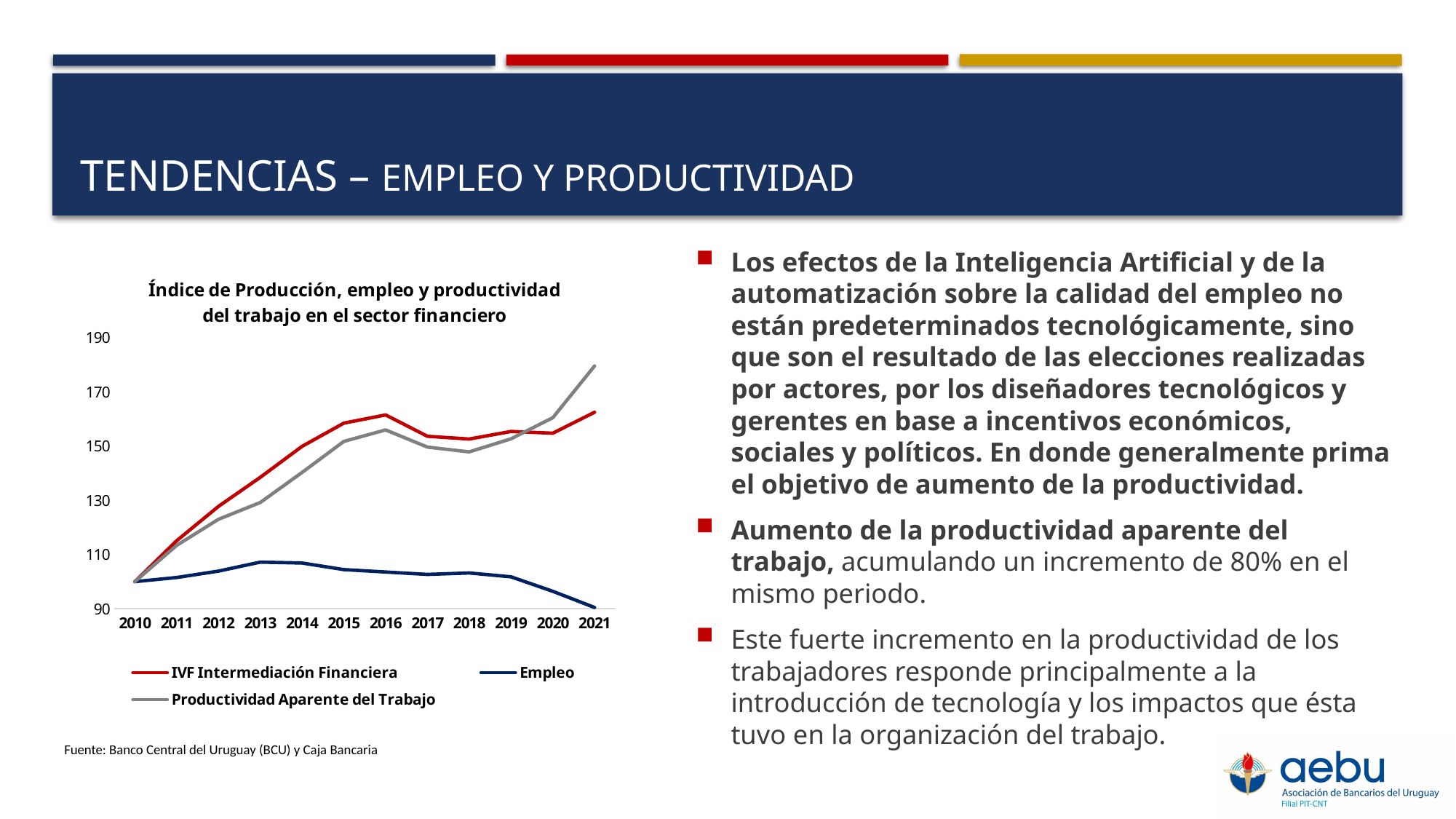
How many years are plotted along the x axis of the chart? 12 Which series has the lowest value in 2021? Empleo What kind of chart is shown on the slide? line chart Which series has the highest value in 2021? Productividad Aparente del Trabajo Is the value for Productividad Aparente del Trabajo in 2021 greater or less than 170? greater In 2021, which is larger: IVF Intermediación Financiera or Empleo? IVF Intermediación Financiera Does the Productividad Aparente del Trabajo series rise or fall between 2010 and 2021? rise How many series does the chart legend list? 3 Is the value for Empleo in 2021 greater or less than 110? less What is the title of the chart? Índice de Producción, empleo y productividad del trabajo en el sector financiero Does the Empleo series rise or fall between 2013 and 2021? fall Is the value for IVF Intermediación Financiera in 2016 greater or less than 150? greater